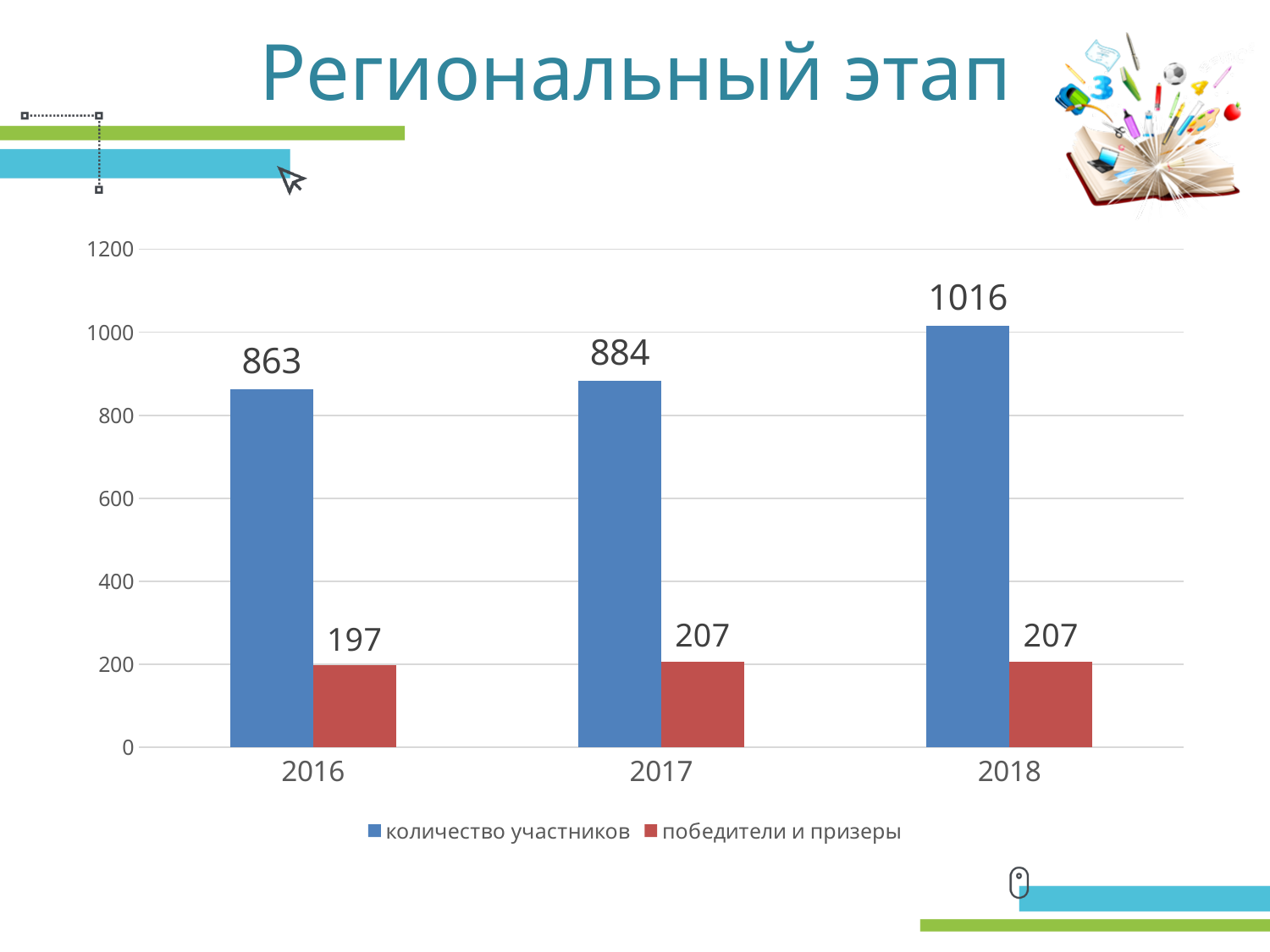
How many years are shown on the x axis? 3 Is the value for "количество участников" in 2018 greater or less than 1000? greater Which year has the lowest value for "победители и призеры"? 2016 What kind of chart is shown on the slide? bar chart What is the value of "количество участников" for 2017? 884 Which is larger: "количество участников" in 2016 or in 2017? 2017 What is the value of "количество участников" for 2018? 1016 How many series does the legend list? 2 What is the difference between "количество участников" in 2018 and in 2016? 153 Does the value for "количество участников" rise or fall from 2016 to 2018? rise What is the value of "победители и призеры" for 2016? 197 Which year has the highest value for "количество участников"? 2018